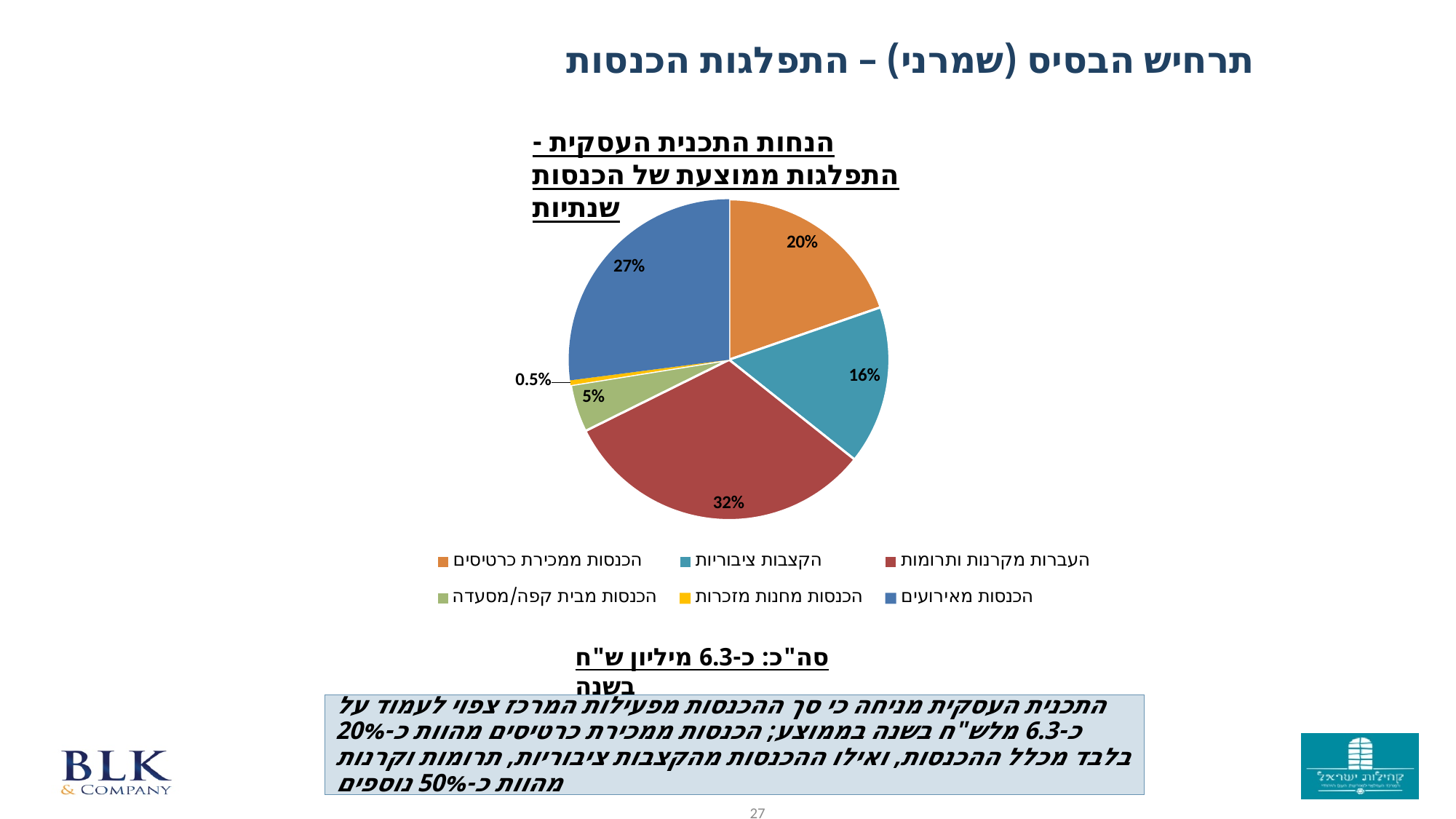
What share of annual income comes from העברות מקרנות ותרומות? 32% What share of annual income comes from הקצבות ציבוריות? 16% How many income categories does the legend list? 6 What colour is the slice for הכנסות מבית קפה/מסעדה? green What share of annual income comes from הכנסות מחנות מזכרות? 0.5% What share of annual income comes from הכנסות מאירועים? 27% Which income source has the smallest share of the pie? הכנסות מחנות מזכרות What is the difference in percentage points between העברות מקרנות ותרומות and הכנסות מאירועים? 5 Which income source has the largest share of the pie? העברות מקרנות ותרומות Which is larger: the share for הכנסות ממכירת כרטיסים or the share for הקצבות ציבוריות? הכנסות ממכירת כרטיסים What type of chart is shown on the slide? pie chart What share of annual income comes from הכנסות ממכירת כרטיסים? 20%